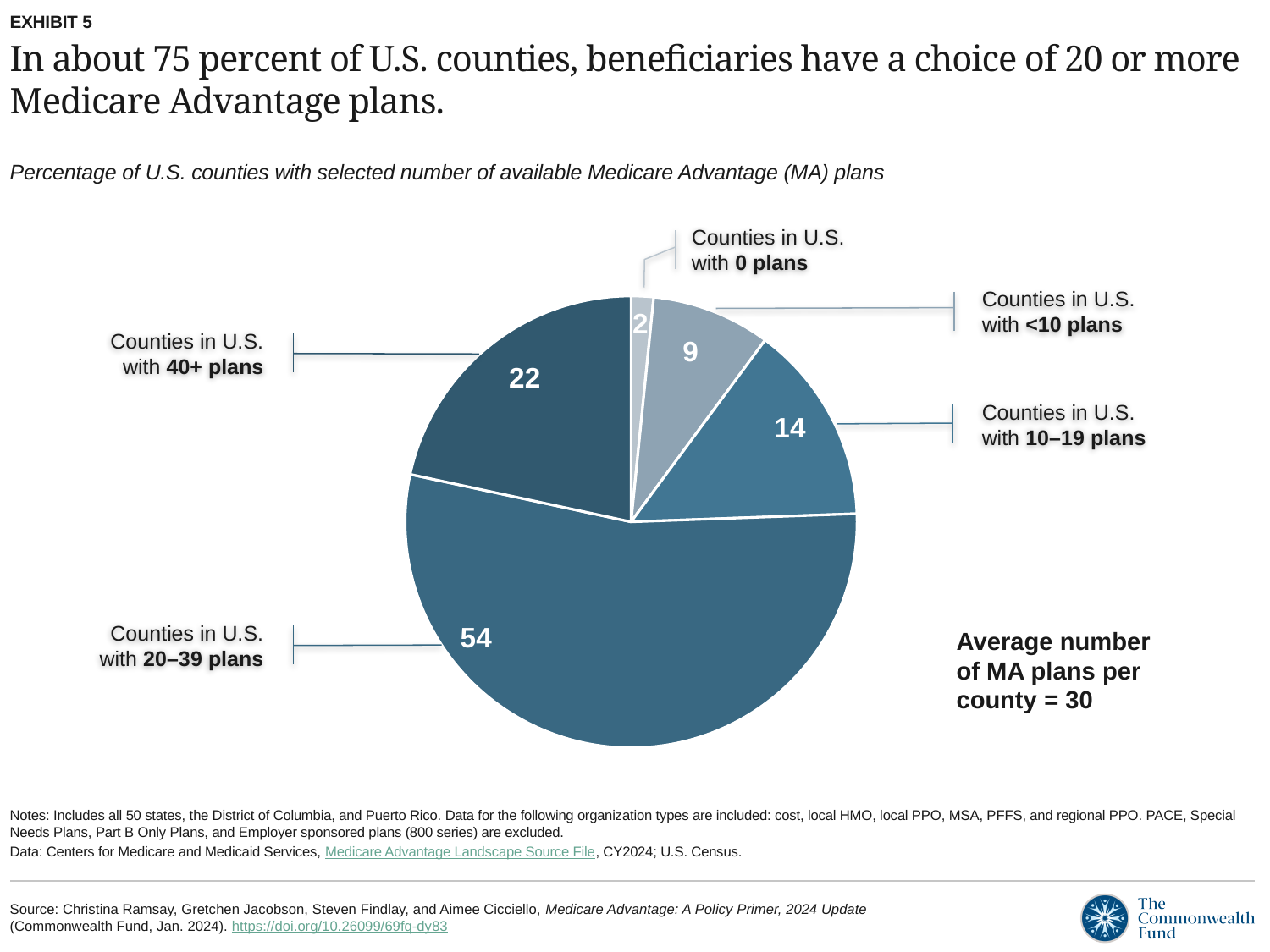
How many slices does the pie chart have? 5 According to the text next to the chart, what is the average number of MA plans per county? 30 Which category of counties has the largest slice of the pie? Counties in U.S. with 20–39 plans Which category of counties has the smallest slice of the pie? Counties in U.S. with 0 plans What value is shown for counties in the U.S. with 40+ plans? 22 Which is larger: the value for counties with <10 plans or the value for counties with 10–19 plans? Counties in U.S. with 10–19 plans What is the difference between the value for counties with 20–39 plans and the value for counties with 40+ plans? 32 What is the combined value of the slices for counties with 20–39 plans and counties with 40+ plans? 76 What value is shown for counties in the U.S. with 10–19 plans? 14 What value is shown for counties in the U.S. with 0 plans? 2 What percentage of U.S. counties have 20–39 Medicare Advantage plans available? 54 What kind of chart is shown on the slide? Pie chart